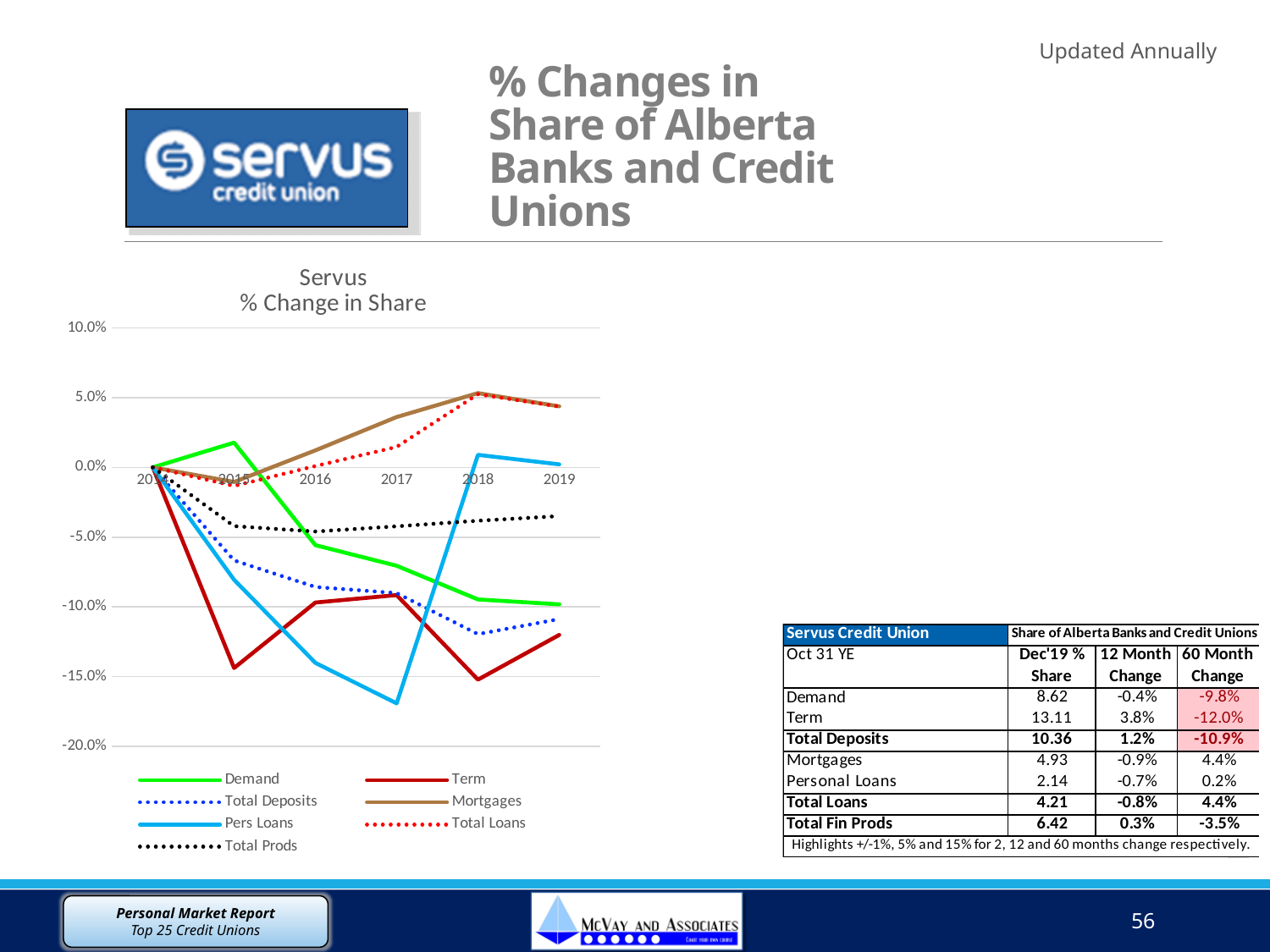
How many series does the legend of the Servus % Change in Share chart list? 7 In 2016, which is higher, Demand or Term? Demand Which series is drawn as a solid green line? Demand Is the value for Demand in 2019 greater or less than -5.0%? less How many years are plotted along the x axis of the chart? 6 Which series has the highest value in 2017? Mortgages Is the value for Term in 2015 greater or less than -10.0%? less Is the value for Mortgages in 2017 greater or less than 0.0%? greater Which series has the lowest value in 2017? Pers Loans What kind of chart is shown on the slide? line chart Does the Mortgages series rise or fall from 2014 to 2018? rise